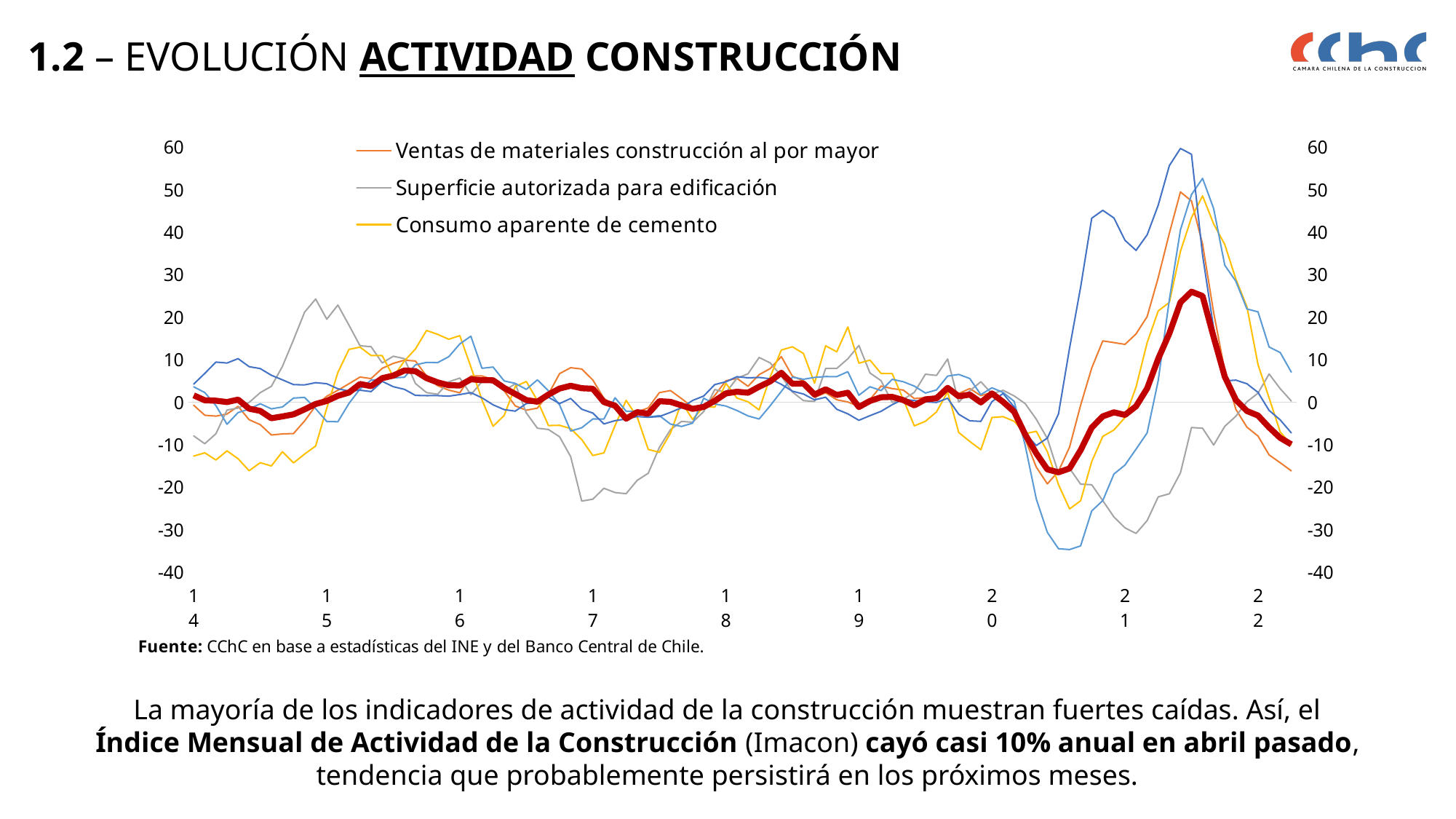
Which series are listed in the chart legend? Ventas de materiales construcción al por mayor; Superficie autorizada para edificación; Consumo aparente de cemento Is the peak value of Superficie autorizada para edificación around 2015 greater or less than 20? greater How many series does the chart legend list? 3 Is the peak value of Ventas de materiales construcción al por mayor around 2021 greater or less than 40? greater How many year labels are shown on the x axis? 9 Does the Ventas de materiales construcción al por mayor line rise or fall from its 2021 peak to the end of the series in 2022? fall What colour is the line for Consumo aparente de cemento? yellow Is the peak value of Consumo aparente de cemento around 2021 greater or less than 40? greater Does the Superficie autorizada para edificación line rise or fall from the start of 2014 to its peak in 2015? rise What kind of chart is shown on the slide? line chart